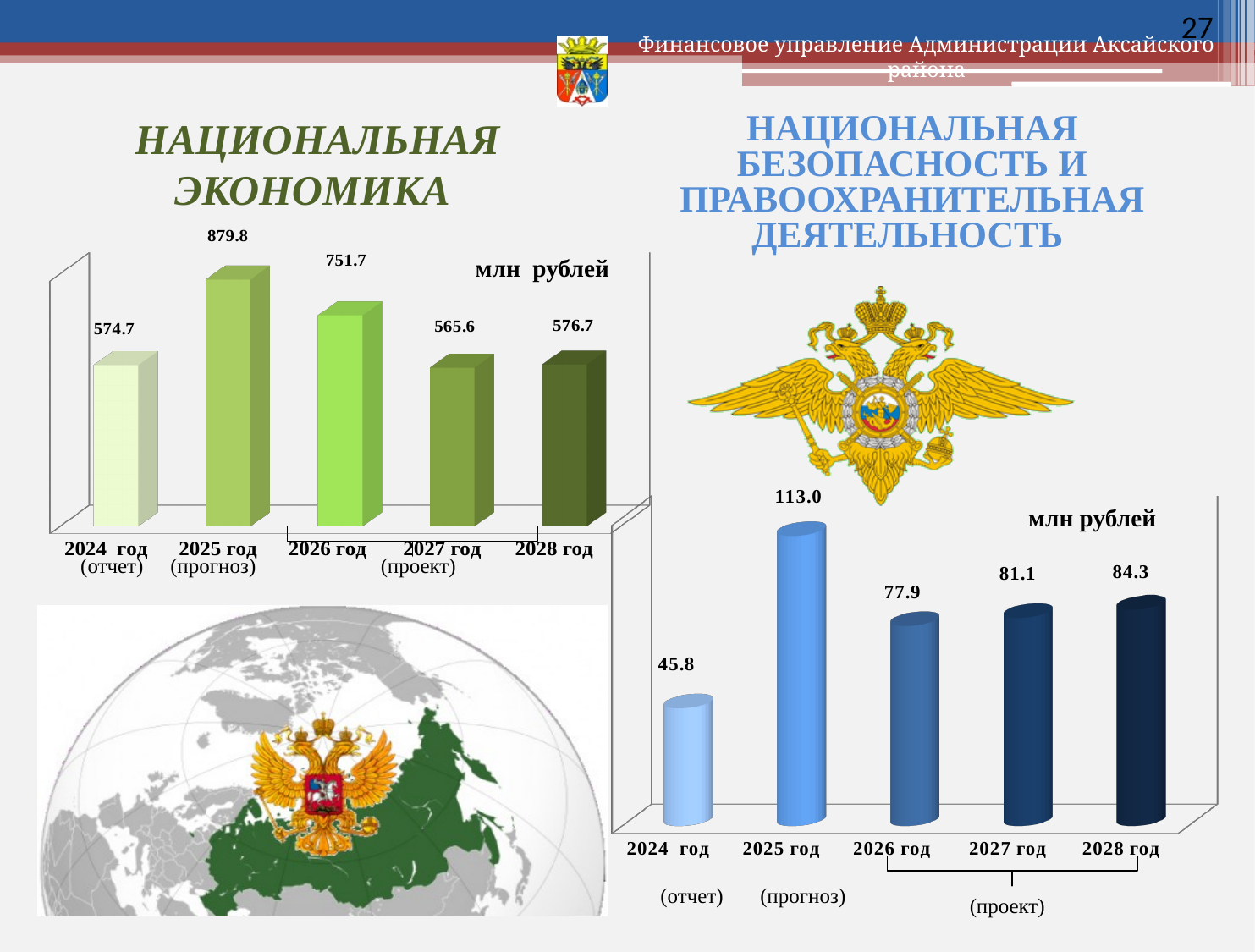
What kind of chart is the 'НАЦИОНАЛЬНАЯ БЕЗОПАСНОСТЬ И ПРАВООХРАНИТЕЛЬНАЯ ДЕЯТЕЛЬНОСТЬ' chart? bar chart In the 'НАЦИОНАЛЬНАЯ ЭКОНОМИКА' chart, which year has the highest value? 2025 год In the 'НАЦИОНАЛЬНАЯ ЭКОНОМИКА' chart, what is the difference between the values for 2025 год and 2026 год? 128.1 In the 'НАЦИОНАЛЬНАЯ ЭКОНОМИКА' chart, which year has the lowest value? 2027 год In the 'НАЦИОНАЛЬНАЯ ЭКОНОМИКА' chart, how many bars are plotted? 5 In the 'НАЦИОНАЛЬНАЯ БЕЗОПАСНОСТЬ И ПРАВООХРАНИТЕЛЬНАЯ ДЕЯТЕЛЬНОСТЬ' chart, what is the value for 2024 год? 45.8 In the 'НАЦИОНАЛЬНАЯ БЕЗОПАСНОСТЬ И ПРАВООХРАНИТЕЛЬНАЯ ДЕЯТЕЛЬНОСТЬ' chart, what is the difference between the values for 2025 год and 2024 год? 67.2 In the 'НАЦИОНАЛЬНАЯ ЭКОНОМИКА' chart, what is the value for 2025 год? 879.8 In the 'НАЦИОНАЛЬНАЯ БЕЗОПАСНОСТЬ И ПРАВООХРАНИТЕЛЬНАЯ ДЕЯТЕЛЬНОСТЬ' chart, what is the value for 2028 год? 84.3 In the 'НАЦИОНАЛЬНАЯ ЭКОНОМИКА' chart, what is the value for 2027 год? 565.6 In the 'НАЦИОНАЛЬНАЯ БЕЗОПАСНОСТЬ И ПРАВООХРАНИТЕЛЬНАЯ ДЕЯТЕЛЬНОСТЬ' chart, do the values rise or fall from 2026 год to 2028 год? rise In the 'НАЦИОНАЛЬНАЯ БЕЗОПАСНОСТЬ И ПРАВООХРАНИТЕЛЬНАЯ ДЕЯТЕЛЬНОСТЬ' chart, which year has the highest value? 2025 год